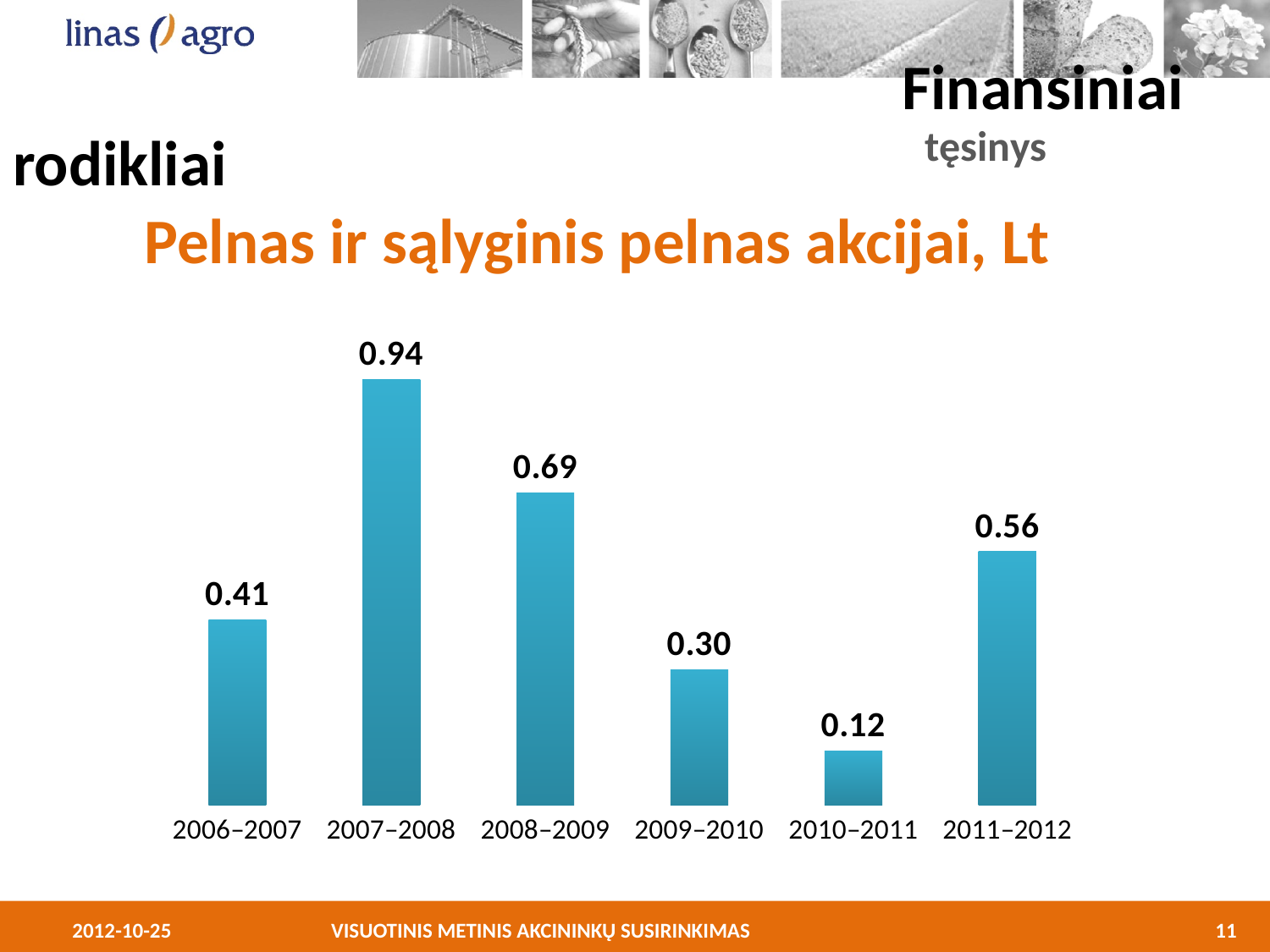
How many periods are shown on the chart? 6 What kind of chart is shown on the slide? Bar chart What is the value for 2011–2012? 0.56 Which period has the highest value? 2007–2008 What is the difference between the values for 2011–2012 and 2010–2011? 0.44 Which period has the lowest value? 2010–2011 What is the value for 2010–2011? 0.12 What is the difference between the values for 2007–2008 and 2008–2009? 0.25 What is the title of the chart? Pelnas ir sąlyginis pelnas akcijai, Lt Which is larger, the value for 2006–2007 or the value for 2009–2010? 2006–2007 What is the value for 2007–2008? 0.94 Do the values rise or fall from 2007–2008 to 2010–2011? Fall